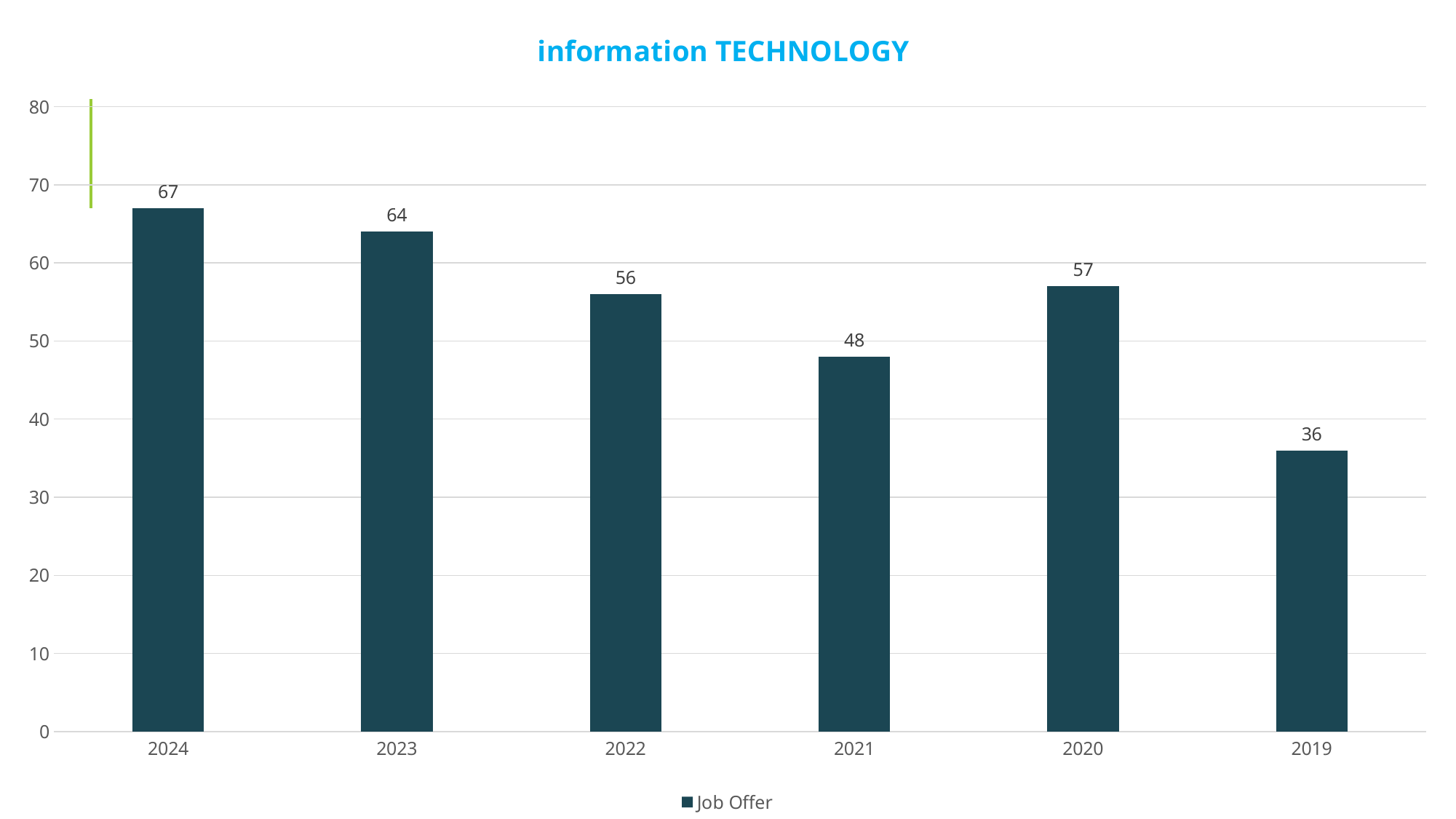
Which year has the highest Job Offer value? 2024 Is the Job Offer value for 2022 greater or less than 50? greater Which year has the lowest Job Offer value? 2019 What is the Job Offer value for 2024? 67 How many series does the legend list? 1 What kind of chart is shown on the slide? bar chart What is the Job Offer value for 2019? 36 What is the difference between the Job Offer values for 2023 and 2022? 8 What is the difference between the Job Offer values for 2024 and 2019? 31 What is the Job Offer value for 2021? 48 How many years are shown on the x axis? 6 Which is larger, the Job Offer value for 2020 or for 2021? 2020